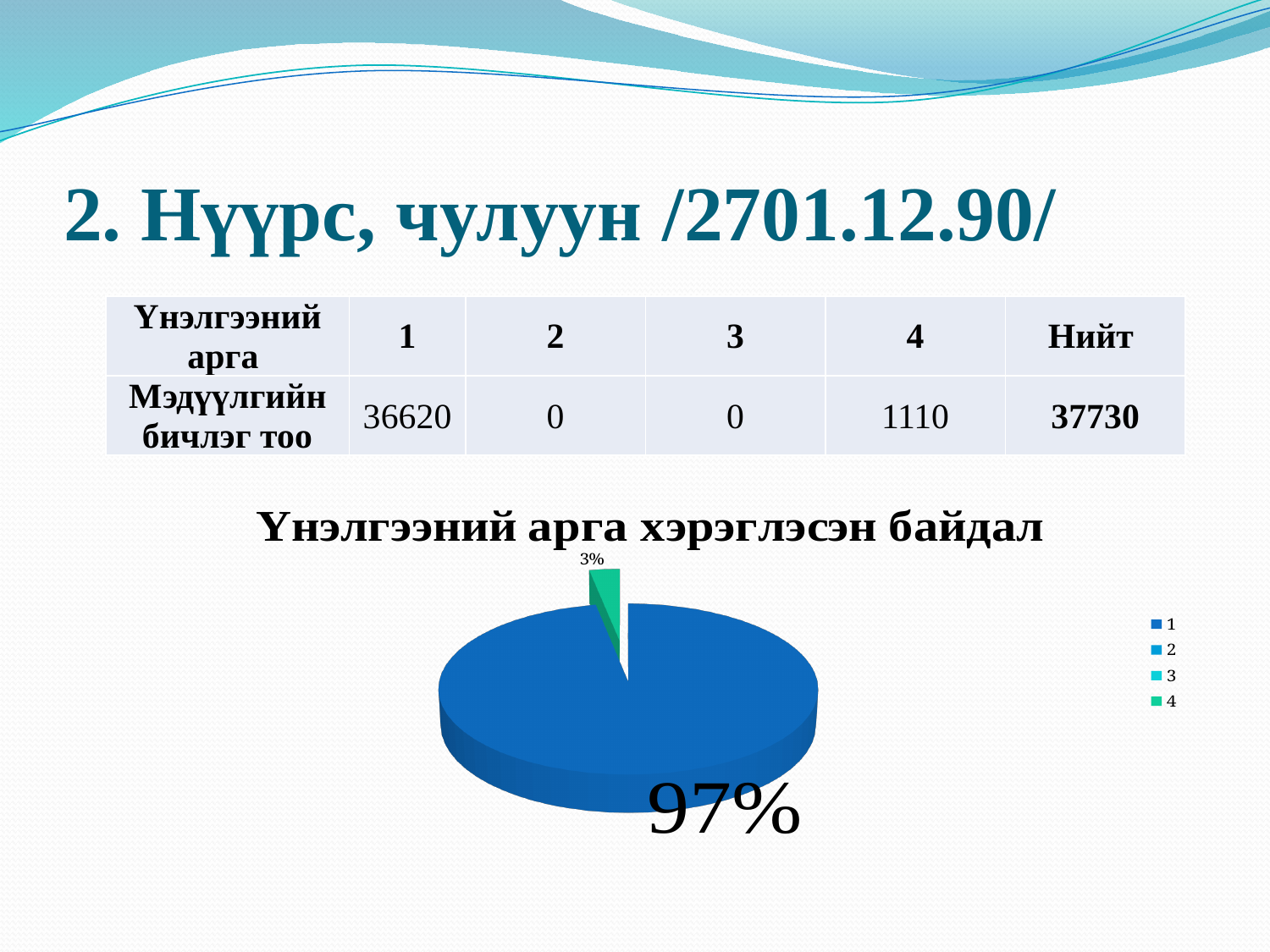
Which category has the largest slice in the pie chart? 1 What kind of chart is shown on the slide? Pie chart Is the share for category 1 greater or less than 50%? greater How many entries does the legend of the pie chart list? 4 What share of the pie does category 1 hold? 97% What is the title of the pie chart? Үнэлгээний арга хэрэглэсэн байдал How many slices are visibly drawn in the pie chart? 2 What colour is the slice for category 1 in the pie chart? Blue What share of the pie does category 4 hold? 3% Which of the visible slices is larger, category 1 or category 4? Category 1 What is the difference in percentage points between the slice for category 1 and the slice for category 4? 94